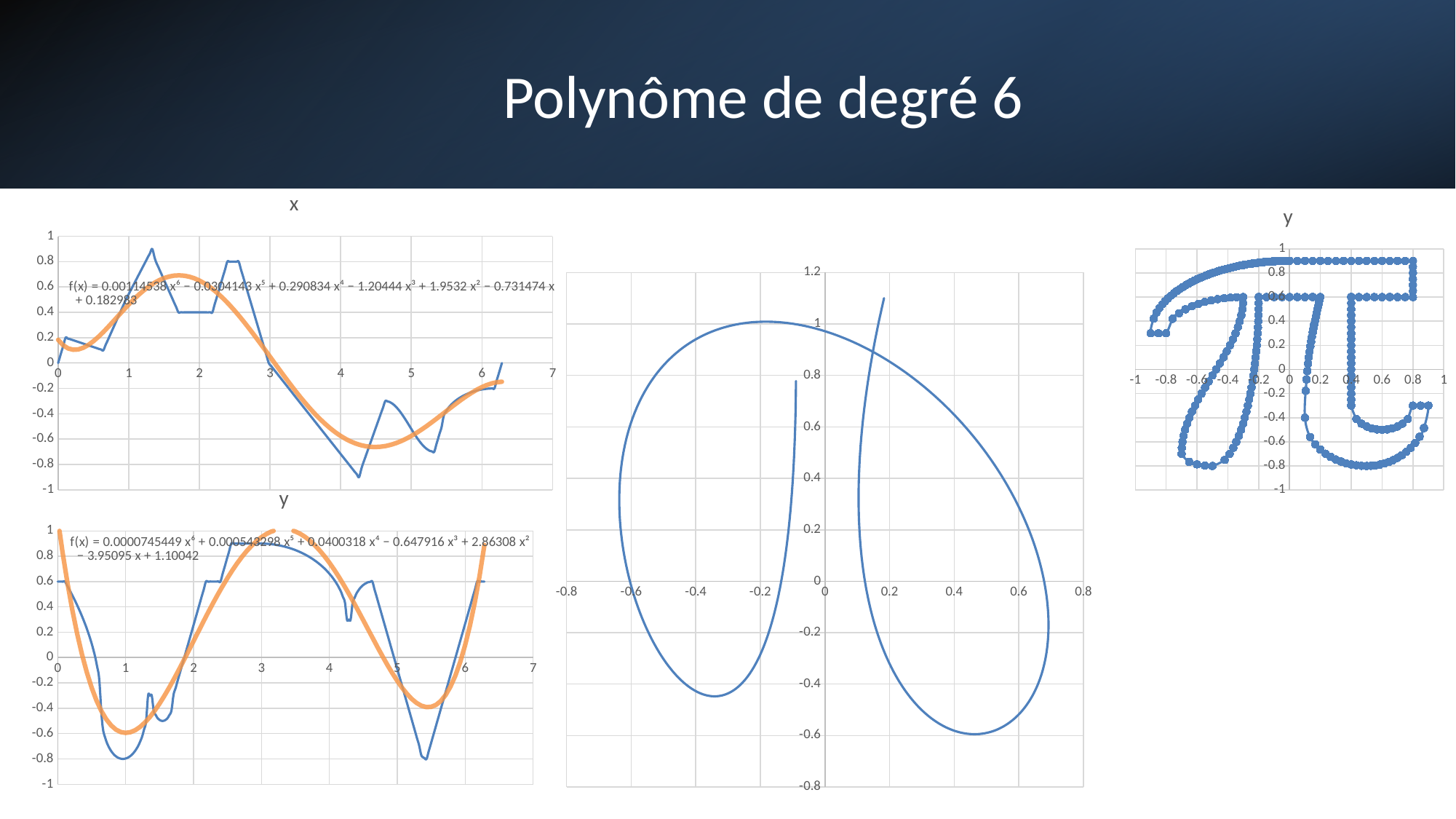
In the top-left chart titled "x", is the highest value reached by the orange curve greater or less than 0.6? greater What is the title of the top-left chart? x In the top-left chart titled "x", does the blue line rise or fall between x = 3 and x = 4? fall In the centre chart, what is the largest value shown on the vertical axis? 1.2 In the bottom-left chart titled "y", what is the coefficient of x² in the fitted polynomial f(x)? 2.86308 In the right-hand chart titled "y", is the top horizontal row of points greater or less than 0.8 on the vertical axis? greater In the centre chart, is the lowest point of the curve greater or less than -0.4 on the vertical axis? less In the top-left chart titled "x", what is the coefficient of x⁶ in the fitted polynomial f(x)? 0.00114538 What kind of chart is the top-left chart titled "x"? line chart In the top-left chart titled "x", what is the constant term of the fitted polynomial f(x) shown on the chart? 0.182983 In the bottom-left chart titled "y", what is the constant term of the fitted polynomial f(x) shown on the chart? 1.10042